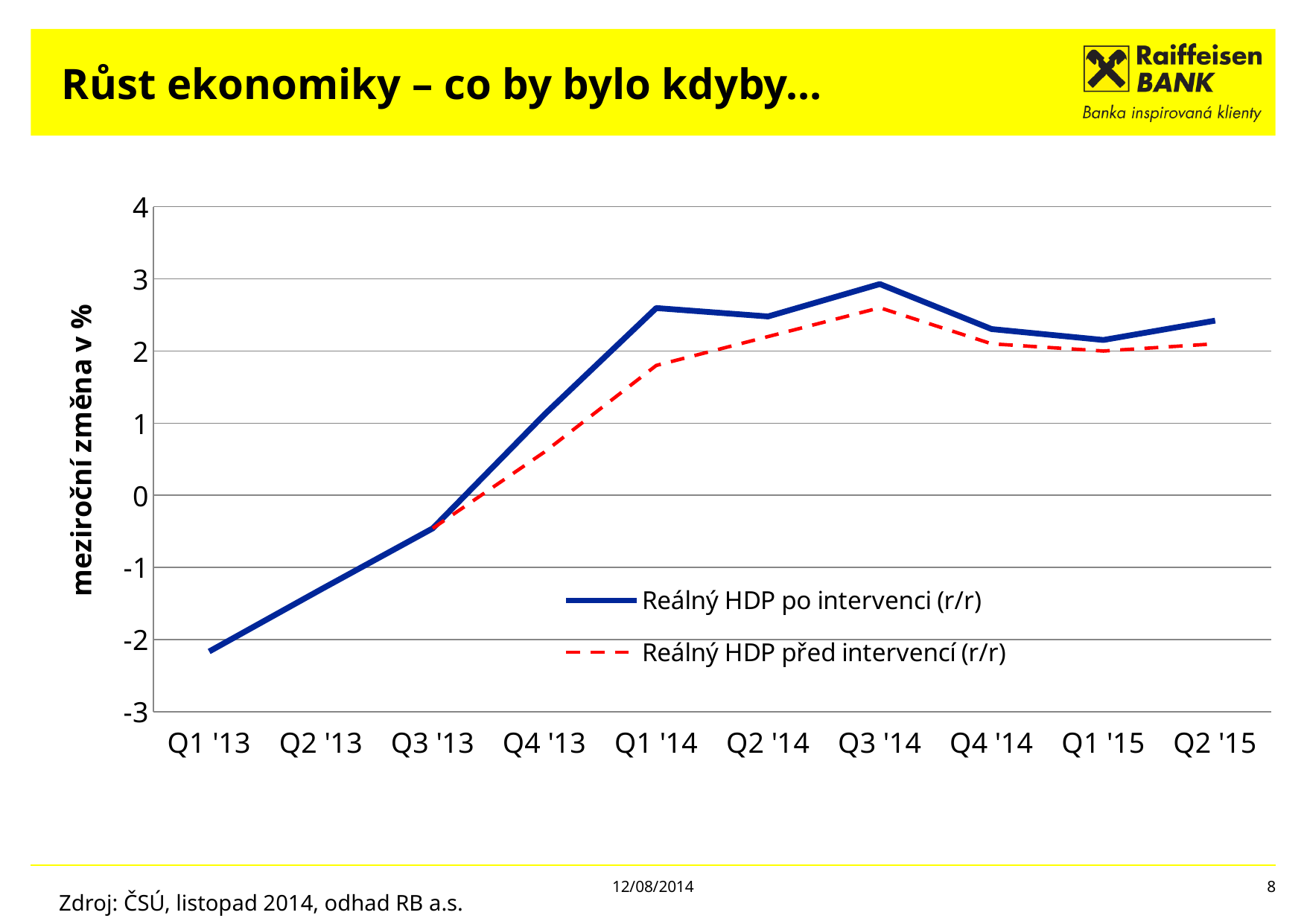
Is the value for 'Reálný HDP před intervencí (r/r)' in Q3 '14 greater or less than 2? greater In which quarter does the 'Reálný HDP po intervenci (r/r)' series have its lowest value? Q1 '13 In which quarter does the 'Reálný HDP před intervencí (r/r)' series reach its highest value? Q3 '14 What kind of chart is shown on the slide? line chart In which quarter does the 'Reálný HDP po intervenci (r/r)' series reach its highest value? Q3 '14 Is the value for 'Reálný HDP po intervenci (r/r)' in Q1 '14 greater or less than 2? greater How many series does the legend list? 2 How many quarters are shown on the x axis? 10 In Q1 '14, which series has the higher value: 'Reálný HDP po intervenci (r/r)' or 'Reálný HDP před intervencí (r/r)'? Reálný HDP po intervenci (r/r) What is the label of the y axis? meziroční změna v % Is the value for 'Reálný HDP po intervenci (r/r)' in Q3 '13 greater or less than 0? less Does the 'Reálný HDP po intervenci (r/r)' series rise or fall from Q1 '13 to Q1 '14? rise